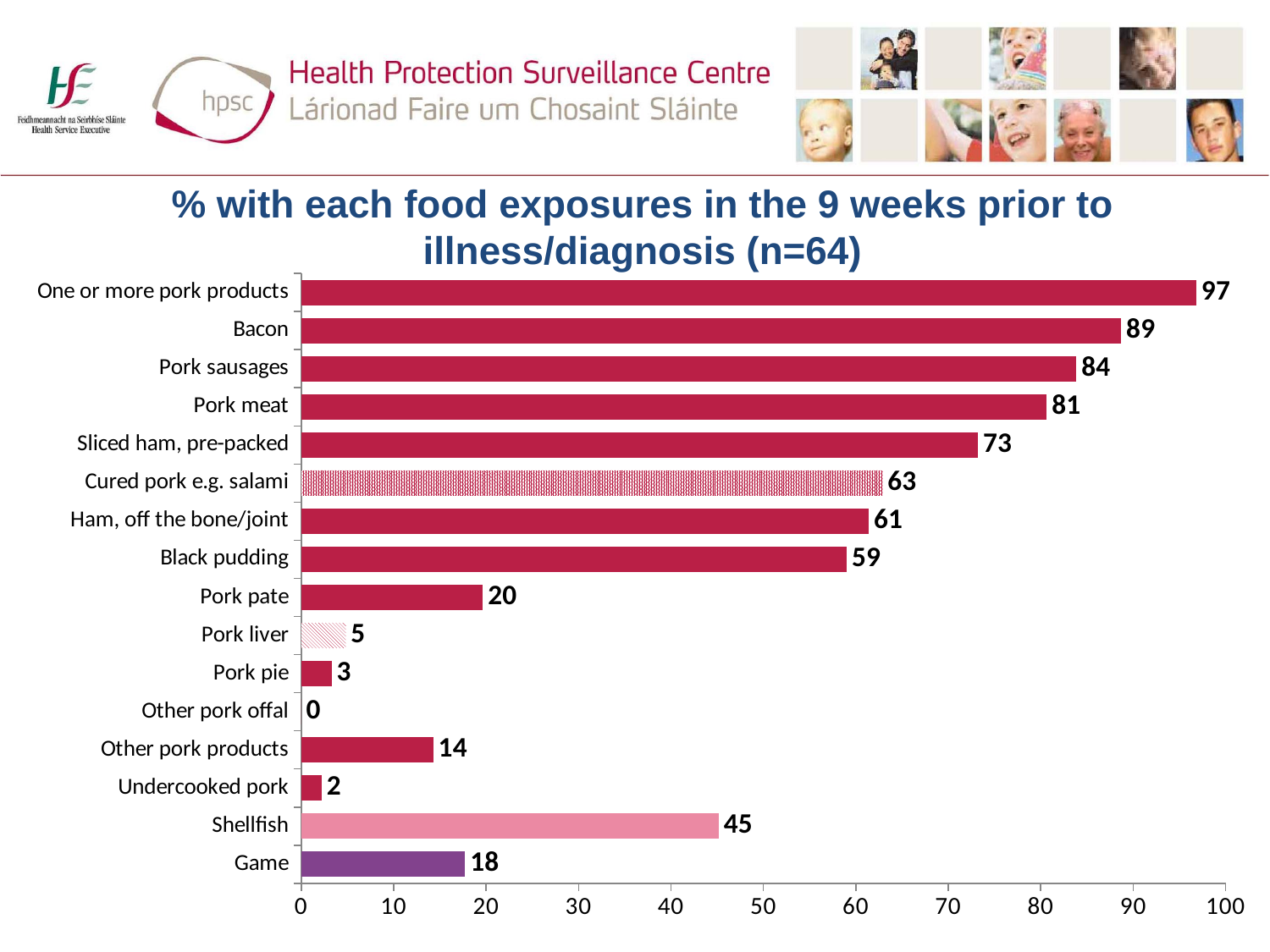
Which category has the highest value? One or more pork products Which is larger, the value for Pork pate or the value for Other pork products? Pork pate What is the value for Shellfish? 45 What is the difference between the values for Pork sausages and Pork meat? 3 What is the value for Cured pork e.g. salami? 63 Which category has the lowest value? Other pork offal What kind of chart is shown on the slide? Bar chart What is the difference between the values for Shellfish and Game? 27 What is the title of the chart? % with each food exposures in the 9 weeks prior to illness/diagnosis (n=64) How many categories are shown in the chart? 16 What is the value for Bacon? 89 Which is larger, the value for Ham, off the bone/joint or the value for Black pudding? Ham, off the bone/joint